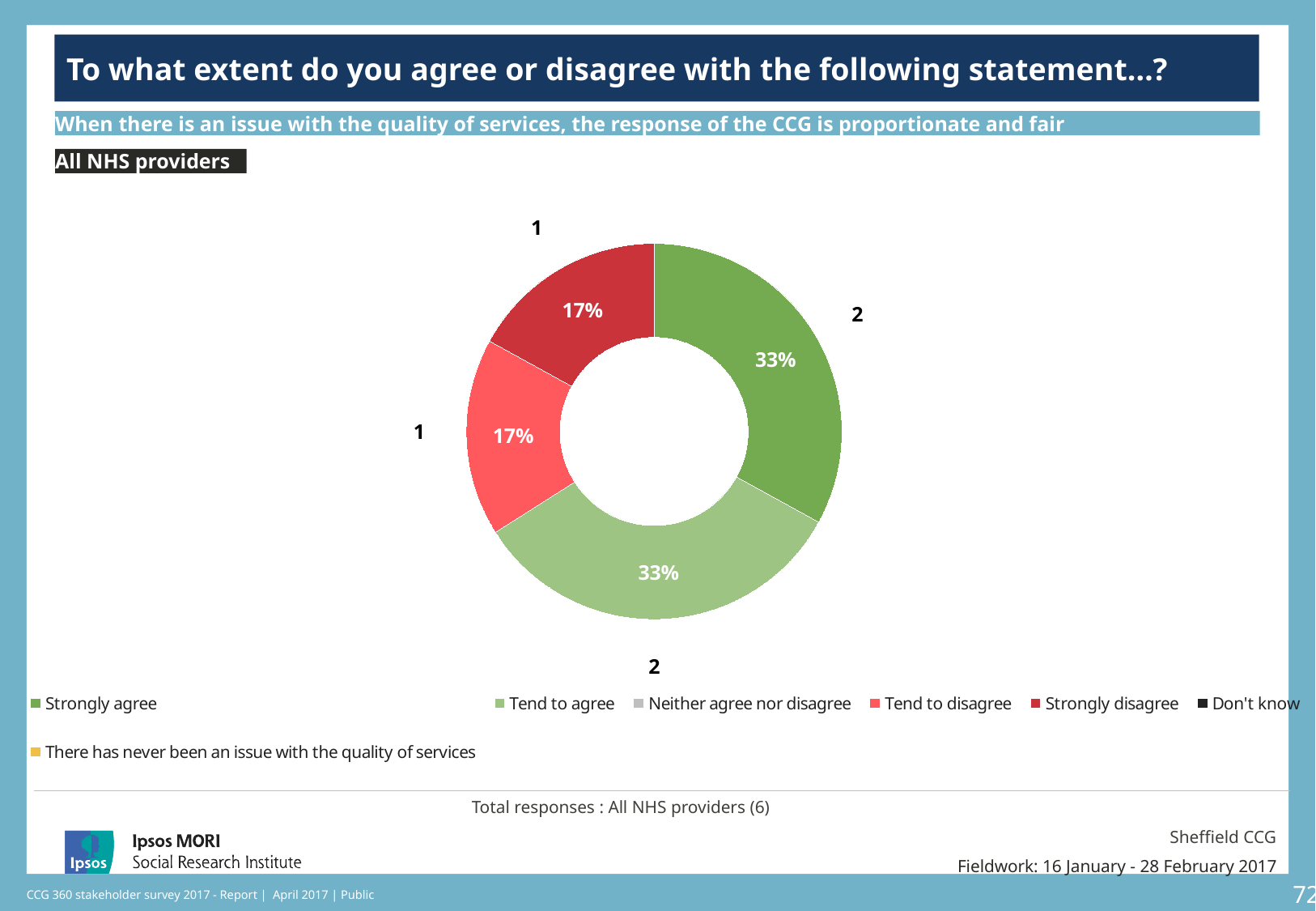
What percentage of respondents said they tend to agree? 33% How many respondents strongly disagreed with the statement? 1 Which is larger, the share for Strongly agree or the share for Strongly disagree? Strongly agree How many respondents strongly agreed with the statement? 2 What percentage of respondents said they strongly disagree? 17% How many slices are shown in the chart? 4 What percentage of respondents said they tend to disagree? 17% What percentage of respondents said they strongly agree? 33% What type of chart is shown on the slide? Pie (donut) chart How many entries does the legend list? 7 What is the combined percentage of respondents who strongly agree or tend to agree? 66% What is the difference in percentage points between the Tend to agree share and the Tend to disagree share? 16 percentage points